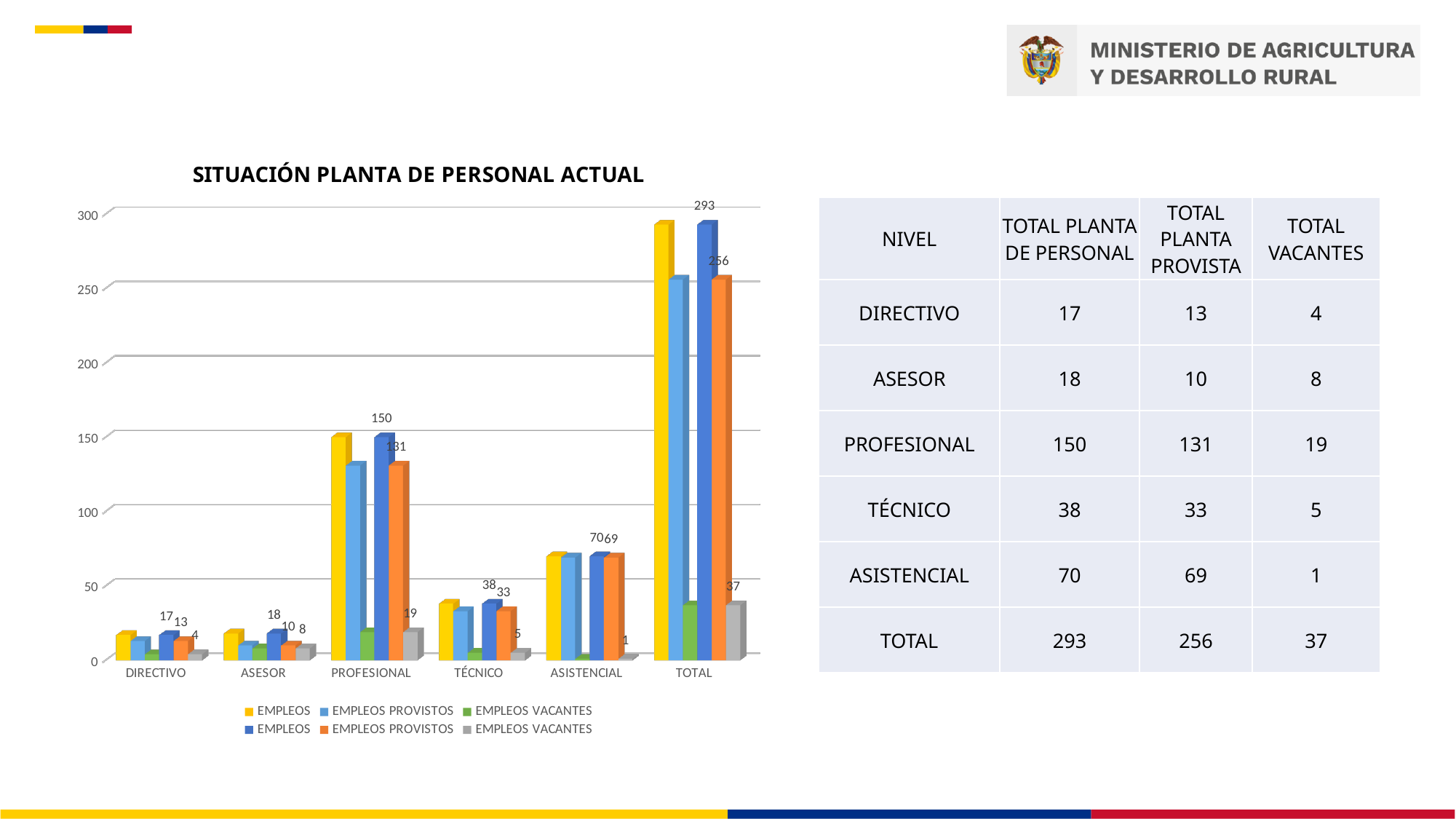
How many categories are shown on the x axis of the chart? 6 What kind of chart is shown on the slide? bar chart What is the EMPLEOS VACANTES value for ASESOR in the chart? 8 Which is larger in the chart: the EMPLEOS value for DIRECTIVO or the EMPLEOS value for ASESOR? ASESOR What is the difference between the EMPLEOS and EMPLEOS PROVISTOS values for TOTAL in the chart? 37 What is the EMPLEOS PROVISTOS value for TÉCNICO in the chart? 33 Excluding the TOTAL category, which category has the highest EMPLEOS value in the chart? PROFESIONAL How many entries does the chart legend list? 6 What is the title of the chart? SITUACIÓN PLANTA DE PERSONAL ACTUAL What is the EMPLEOS value for PROFESIONAL in the chart? 150 Is the EMPLEOS PROVISTOS value for PROFESIONAL greater or less than 100? greater Which category has the lowest EMPLEOS VACANTES value in the chart? ASISTENCIAL